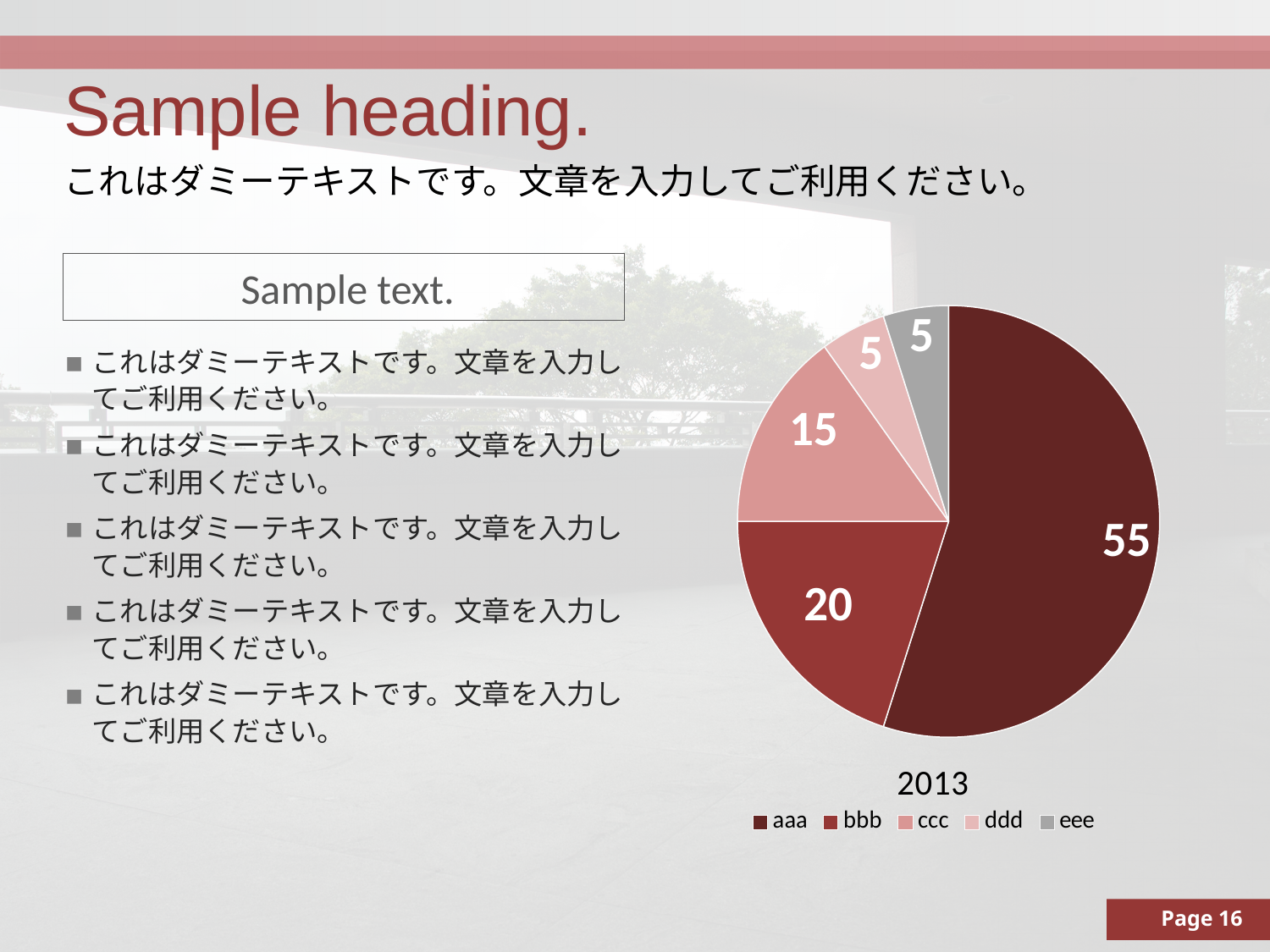
How many entries does the legend of the pie chart list? 5 How many slices does the pie chart have? 5 What is the title of the pie chart? 2013 What share of the whole pie does the aaa slice represent? 55% What kind of chart is shown on the slide? pie chart Which category has the largest slice in the pie chart? aaa What is the difference between the aaa and bbb values in the pie chart? 35 What is the value of the ccc slice in the pie chart? 15 What is the value of the bbb slice in the pie chart? 20 What is the value of the aaa slice in the pie chart? 55 What is the value of the ddd slice in the pie chart? 5 Which is larger in the pie chart, bbb or ccc? bbb